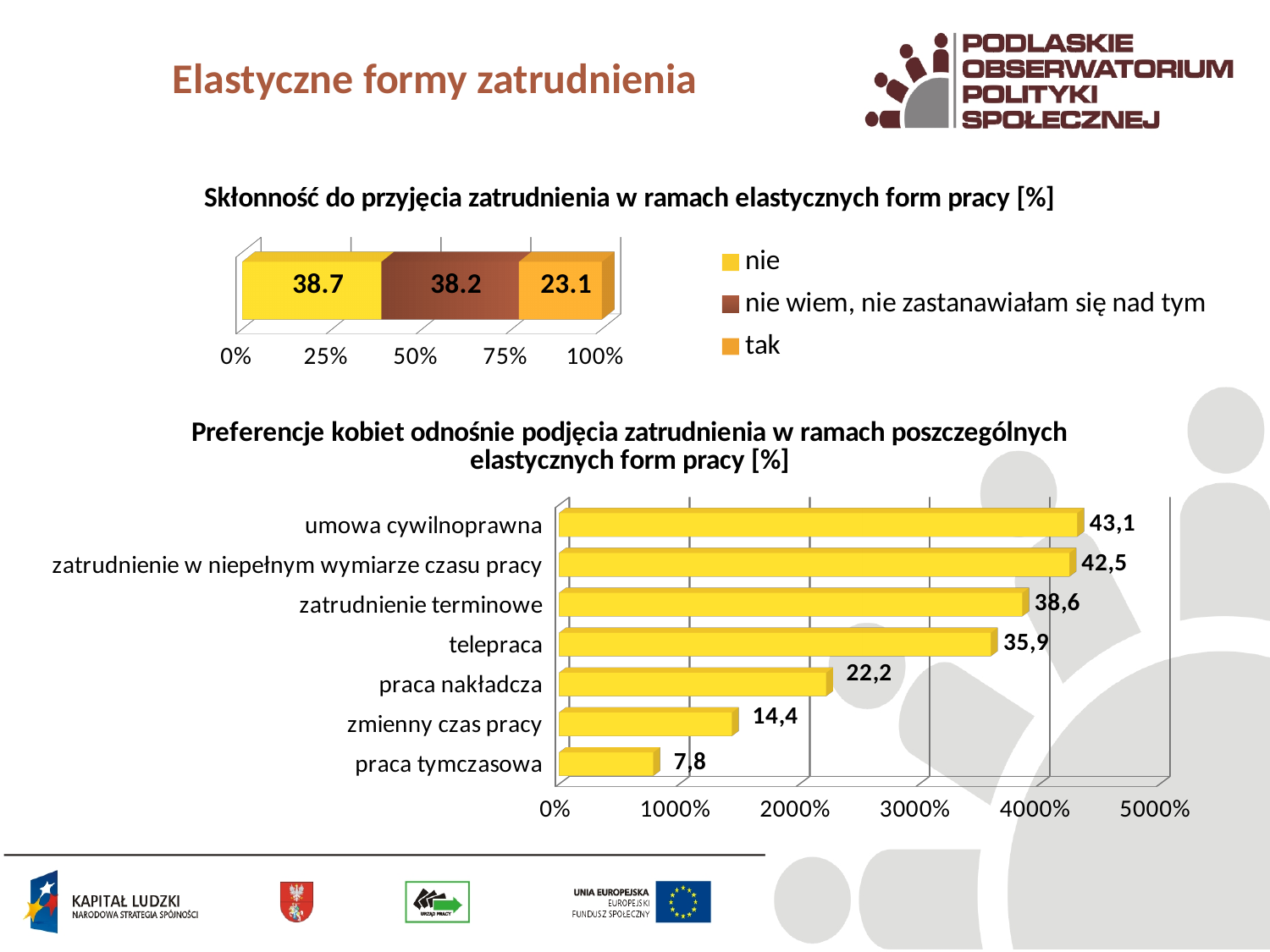
In the bottom chart 'Preferencje kobiet odnośnie podjęcia zatrudnienia w ramach poszczególnych elastycznych form pracy [%]', what is the value for 'telepraca'? 35,9 In the top chart 'Skłonność do przyjęcia zatrudnienia w ramach elastycznych form pracy [%]', what is the value for 'nie'? 38.7 In the top chart 'Skłonność do przyjęcia zatrudnienia w ramach elastycznych form pracy [%]', what is the value for 'tak'? 23.1 In the bottom chart 'Preferencje kobiet odnośnie podjęcia zatrudnienia w ramach poszczególnych elastycznych form pracy [%]', what is the difference between 'zatrudnienie terminowe' and 'zmienny czas pracy'? 24,2 What kind of chart is the bottom chart 'Preferencje kobiet odnośnie podjęcia zatrudnienia w ramach poszczególnych elastycznych form pracy [%]'? bar chart In the top chart 'Skłonność do przyjęcia zatrudnienia w ramach elastycznych form pracy [%]', which series has the smallest value? tak In the top chart 'Skłonność do przyjęcia zatrudnienia w ramach elastycznych form pracy [%]', how many series does the legend list? 3 In the bottom chart 'Preferencje kobiet odnośnie podjęcia zatrudnienia w ramach poszczególnych elastycznych form pracy [%]', which category has the lowest value? praca tymczasowa In the bottom chart 'Preferencje kobiet odnośnie podjęcia zatrudnienia w ramach poszczególnych elastycznych form pracy [%]', what is the value for 'praca nakładcza'? 22,2 In the bottom chart 'Preferencje kobiet odnośnie podjęcia zatrudnienia w ramach poszczególnych elastycznych form pracy [%]', which category has the highest value? umowa cywilnoprawna In the top chart 'Skłonność do przyjęcia zatrudnienia w ramach elastycznych form pracy [%]', what is the total of the stacked bar? 100 In the bottom chart 'Preferencje kobiet odnośnie podjęcia zatrudnienia w ramach poszczególnych elastycznych form pracy [%]', how many categories are shown? 7